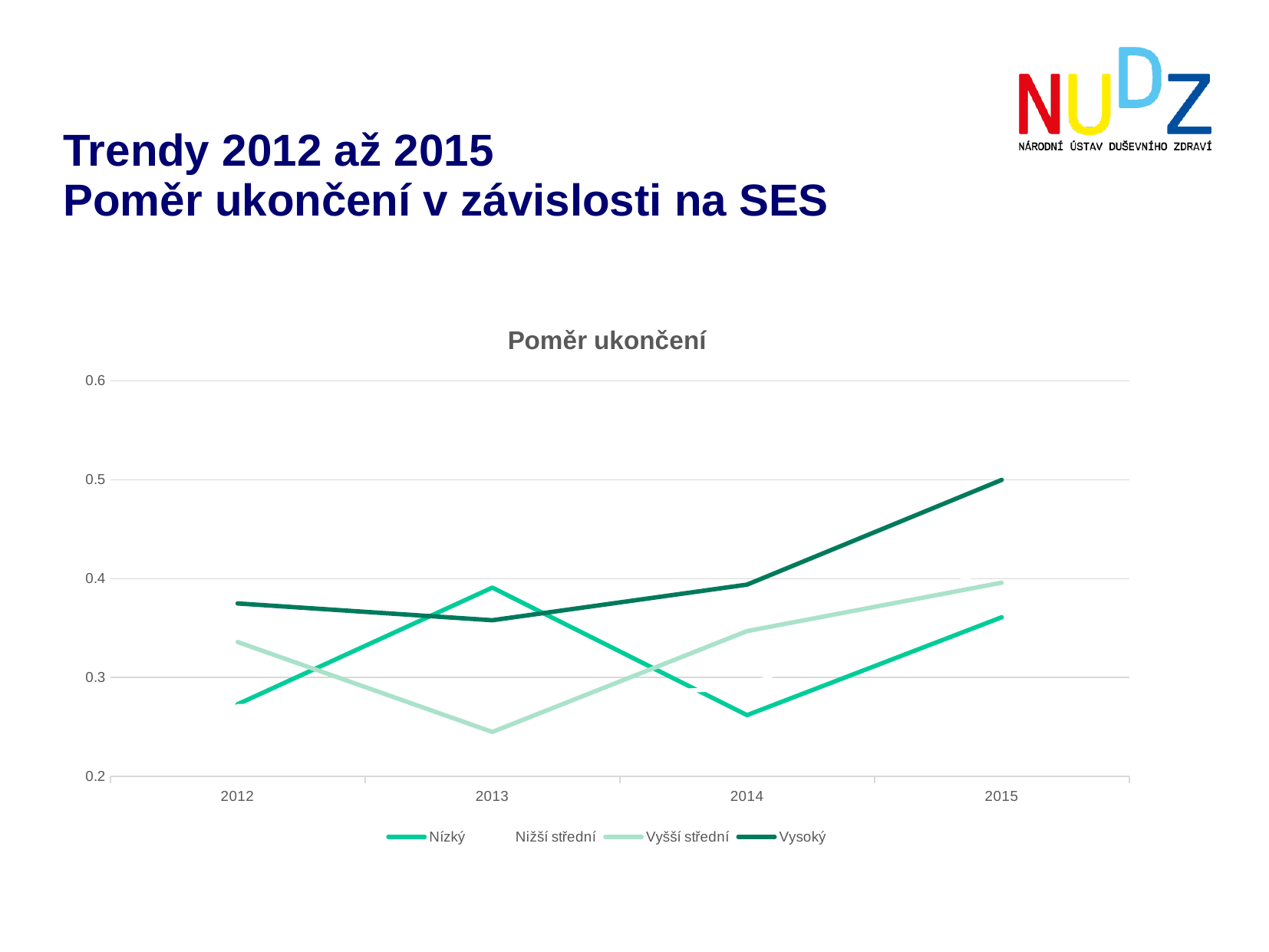
Which series has the highest value in 2015? Vysoký What kind of chart is shown on the slide? line chart How many years are shown on the x axis of the chart? 4 What is the value for Vysoký in 2015? 0.5 Does the Vysoký series rise or fall from 2013 to 2015? rise Is the value for Vyšší střední in 2013 greater or less than 0.3? less Is the value for Nízký in 2015 greater or less than 0.3? greater How many series does the chart legend list? 4 Which series has the lowest value in 2013? Vyšší střední Is the value for Nízký in 2012 greater or less than 0.3? less What is the title of the chart? Poměr ukončení In 2012, which is larger: the value for Vysoký or the value for Nízký? Vysoký